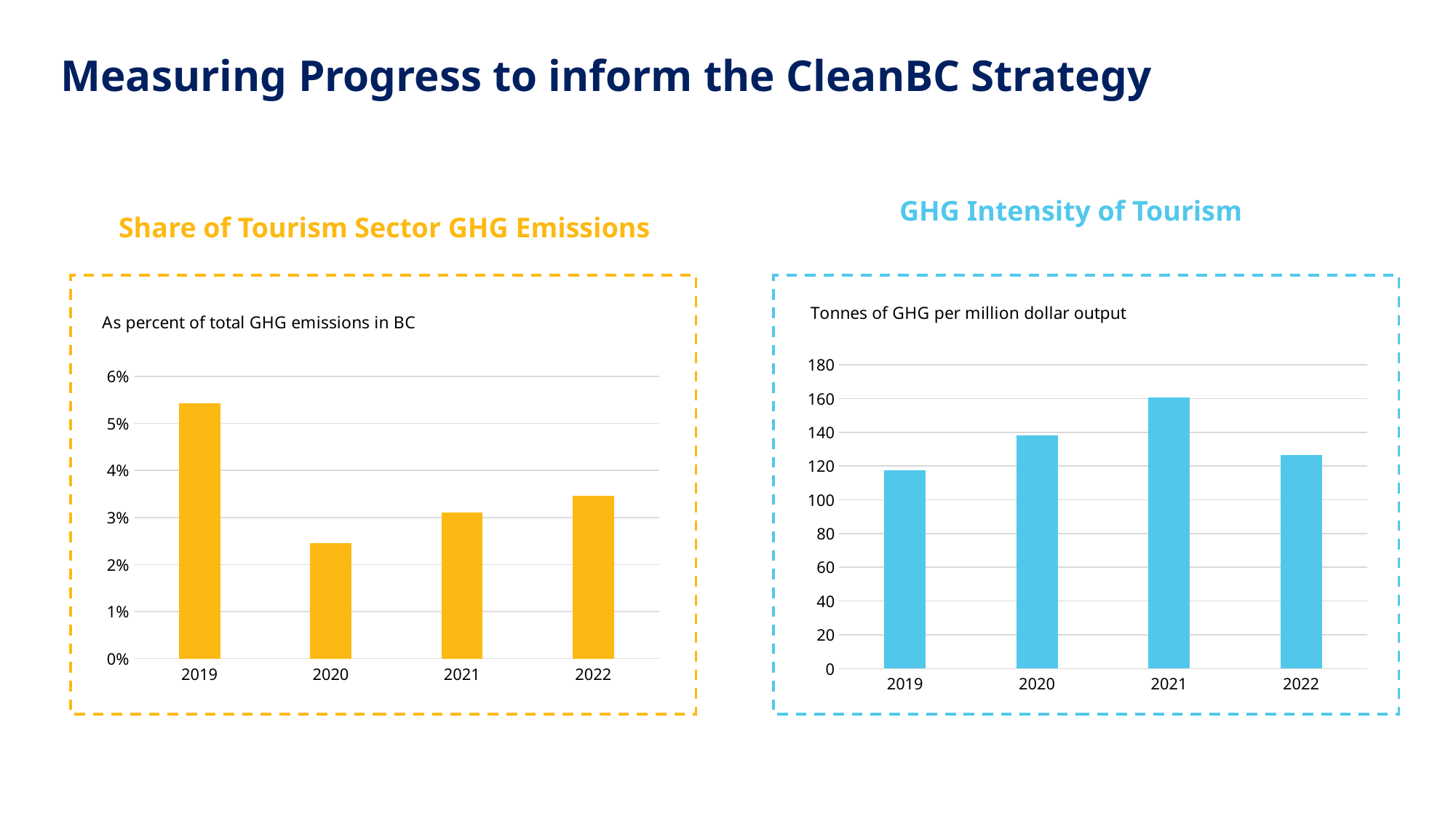
In the 'Share of Tourism Sector GHG Emissions' chart, which year has the highest share? 2019 In the 'Share of Tourism Sector GHG Emissions' chart, which year has the lowest share? 2020 In the 'Share of Tourism Sector GHG Emissions' chart, is the value for 2019 greater or less than 5%? greater In the 'GHG Intensity of Tourism' chart, which year has the lowest value? 2019 In the 'GHG Intensity of Tourism' chart, which year has the highest value? 2021 In the 'GHG Intensity of Tourism' chart, is the value for 2021 greater or less than 140? greater In the 'Share of Tourism Sector GHG Emissions' chart, is the value for 2020 greater or less than 3%? less In the 'Share of Tourism Sector GHG Emissions' chart, which is larger, the value for 2021 or the value for 2022? 2022 What unit is stated in the subtitle of the 'GHG Intensity of Tourism' chart? Tonnes of GHG per million dollar output How many years are shown in the 'Share of Tourism Sector GHG Emissions' chart? 4 What type of chart is the 'GHG Intensity of Tourism' chart? Bar chart